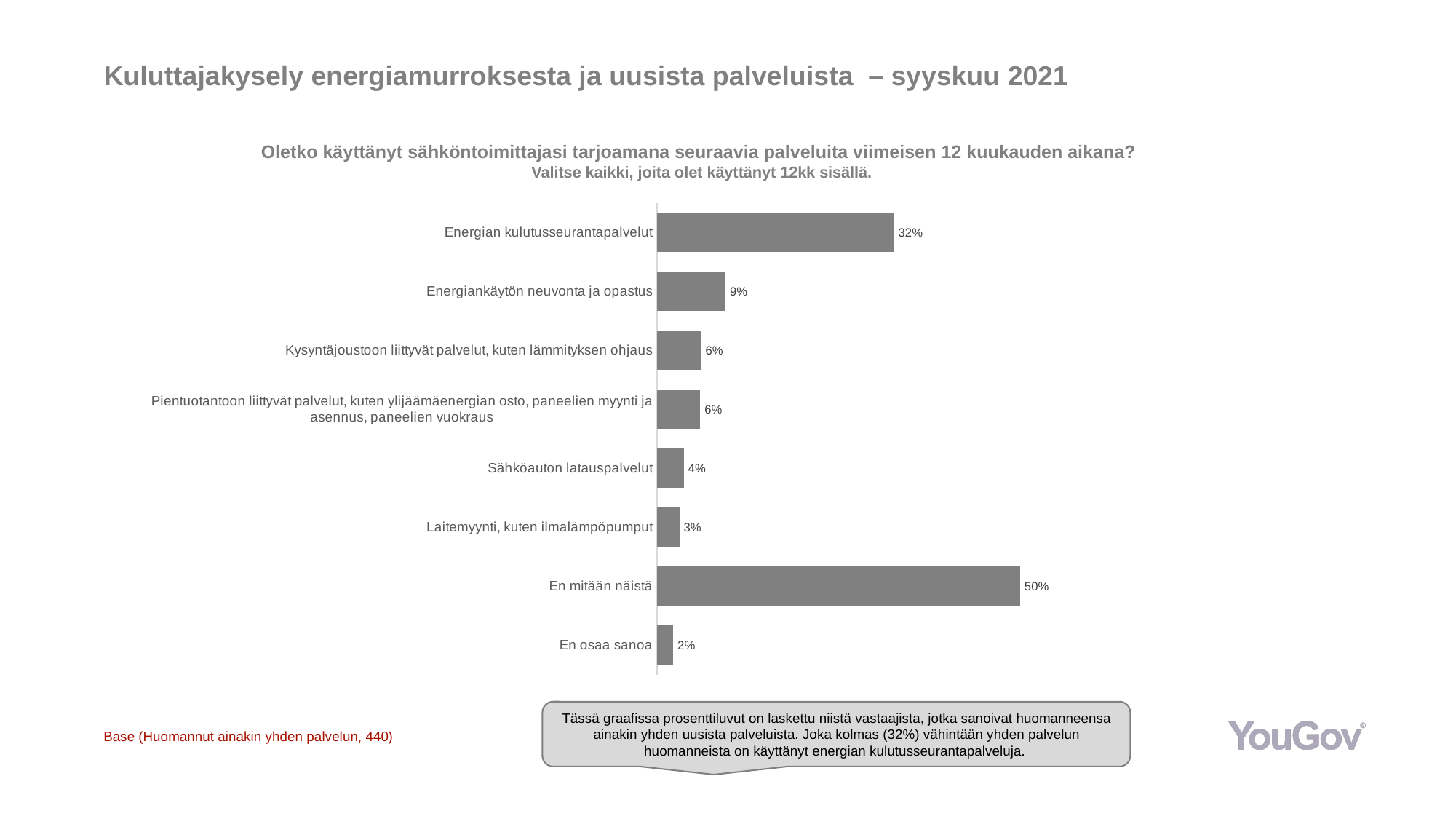
What is the difference between the values for Energiankäytön neuvonta ja opastus and Sähköauton latauspalvelut? 5% Which is larger, the value for Energiankäytön neuvonta ja opastus or the value for Laitemyynti, kuten ilmalämpöpumput? Energiankäytön neuvonta ja opastus What kind of chart is shown on the slide? Bar chart What percentage is shown for Energian kulutusseurantapalvelut? 32% Which category has the lowest value? En osaa sanoa What base size is stated on the slide? 440 How many categories are shown in the chart? 8 What is the difference between the values for En mitään näistä and Energian kulutusseurantapalvelut? 18% Which category has the highest value? En mitään näistä What percentage is shown for Sähköauton latauspalvelut? 4% What is the value for Energiankäytön neuvonta ja opastus? 9% What is the value for En mitään näistä? 50%